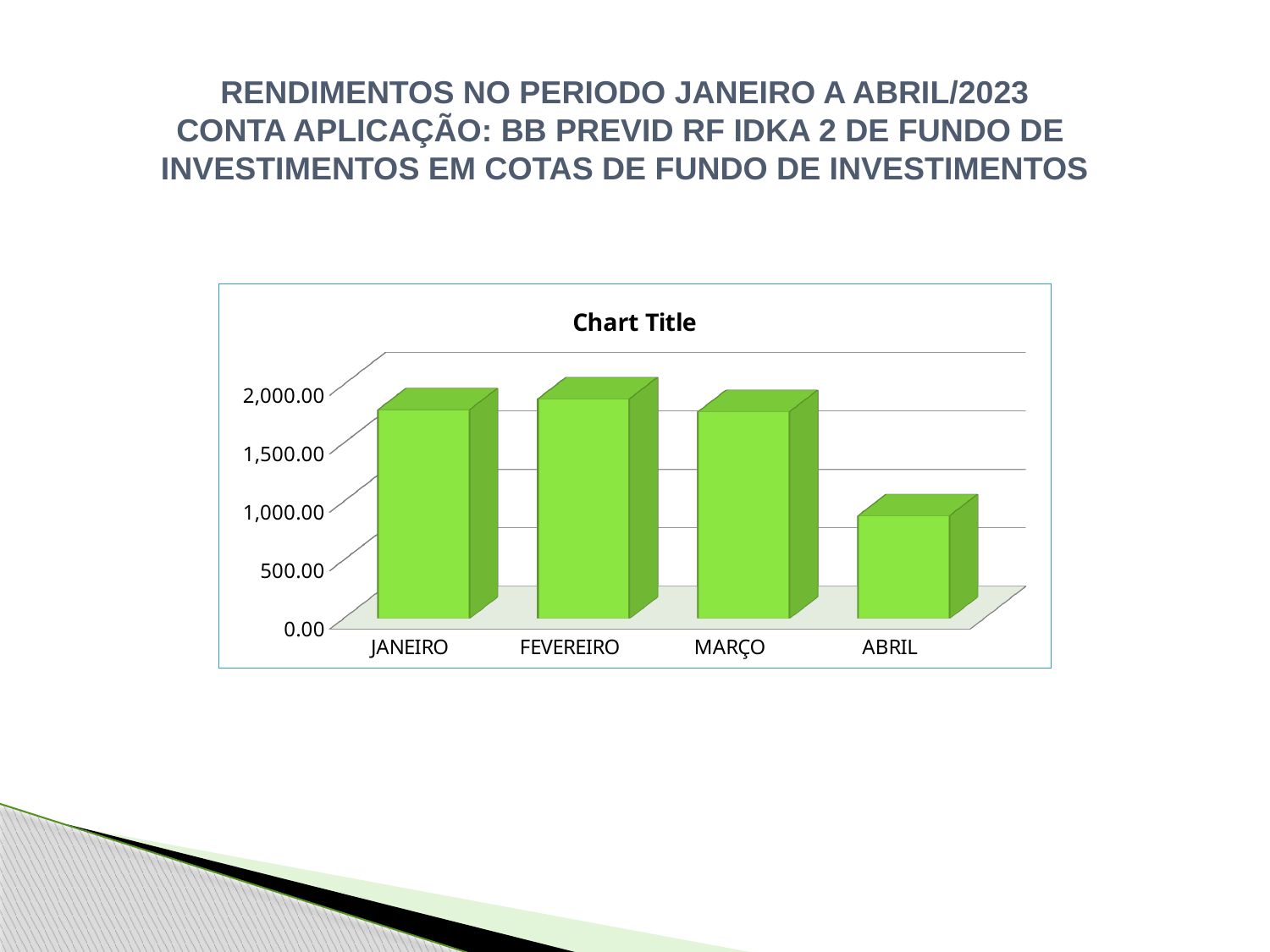
Which month has the highest value on the chart? FEVEREIRO Is the value for JANEIRO greater or less than 1,500.00? greater What kind of chart is shown on the slide? bar chart How many categories (months) are plotted on the chart? 4 Does the value rise or fall from MARÇO to ABRIL? fall Is the value for MARÇO greater or less than 1,000.00? greater Which is larger, the value for JANEIRO or the value for ABRIL? JANEIRO What colour are the bars in the chart? green Which month has the lowest value on the chart? ABRIL Is the value for ABRIL greater or less than 500.00? greater What title is printed above the chart's plot area? Chart Title